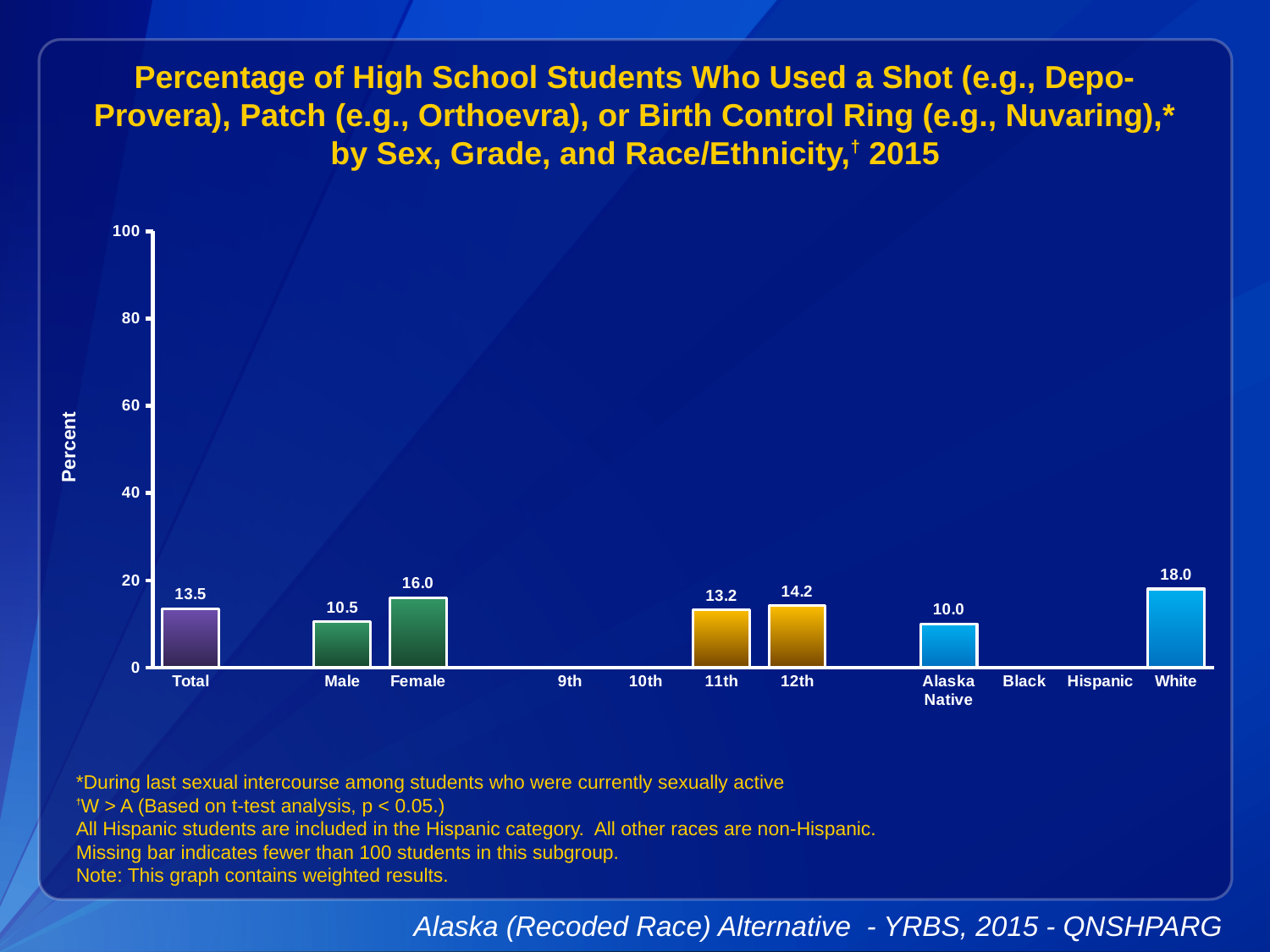
Which is larger, the value for 11th grade or 12th grade? 12th What is the value for 12th grade? 14.2 What is the value for Total? 13.5 What kind of chart is this? bar chart What is the label on the y axis? Percent How many categories have a bar shown? 7 What is the value for Female? 16.0 Which category with a bar has the lowest value? Alaska Native Is the value for White greater or less than 20? less What is the difference between the Female and Male values? 5.5 Which category has the highest value? White What is the value for Alaska Native? 10.0